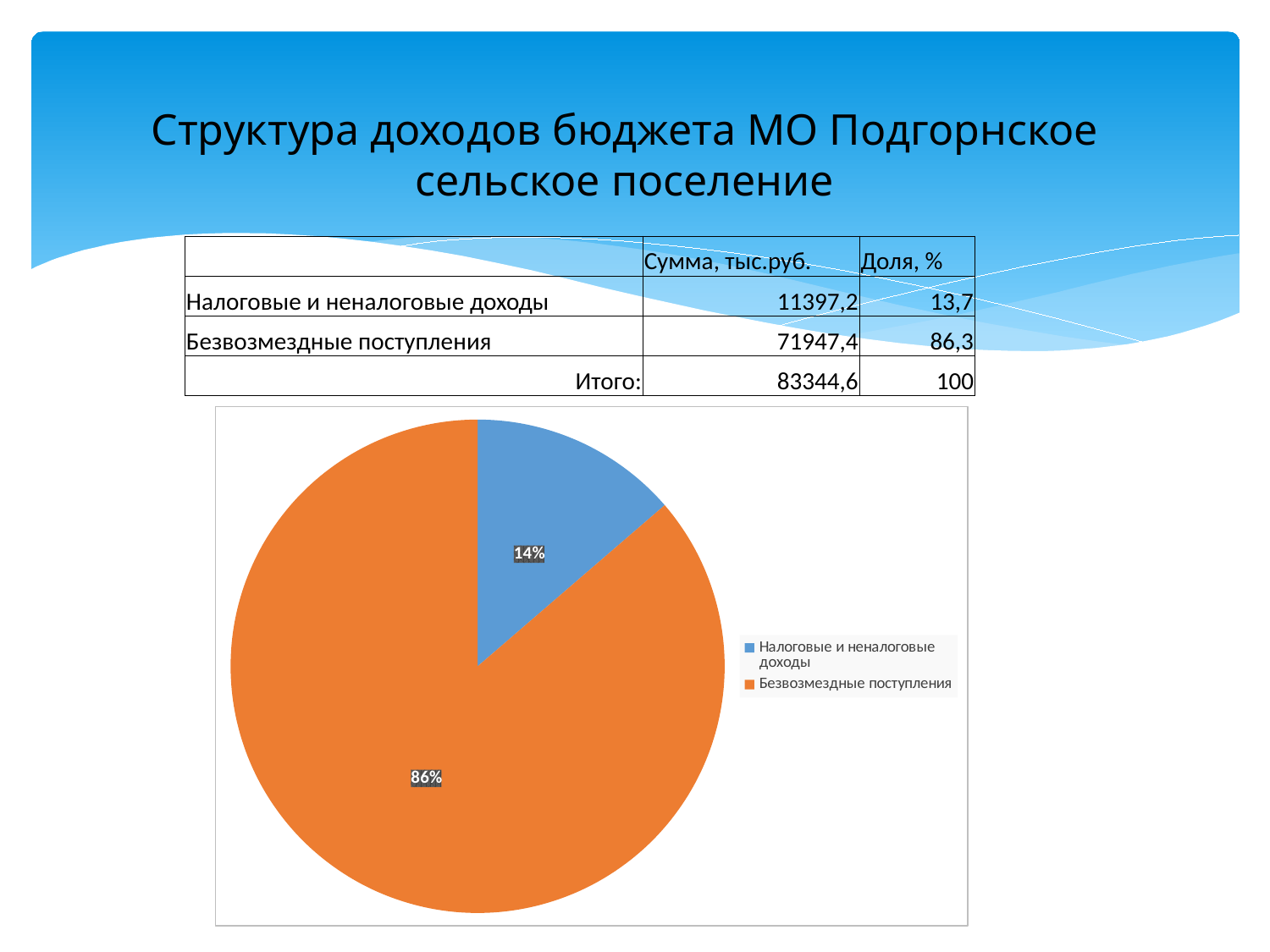
What is the difference in percentage points between the Безвозмездные поступления slice and the Налоговые и неналоговые доходы slice, using the labels on the pie? 72% Which category has the largest slice of the pie? Безвозмездные поступления What colour is the slice for Налоговые и неналоговые доходы? blue Which category has the smallest slice of the pie? Налоговые и неналоговые доходы How many entries does the legend list? 2 What kind of chart is shown on the slide? pie chart What colour is the slice for Безвозмездные поступления? orange What share of the pie does Налоговые и неналоговые доходы have? 14% Which slice is larger: Налоговые и неналоговые доходы or Безвозмездные поступления? Безвозмездные поступления How many slices does the pie chart have? 2 What share of the pie does Безвозмездные поступления have? 86%